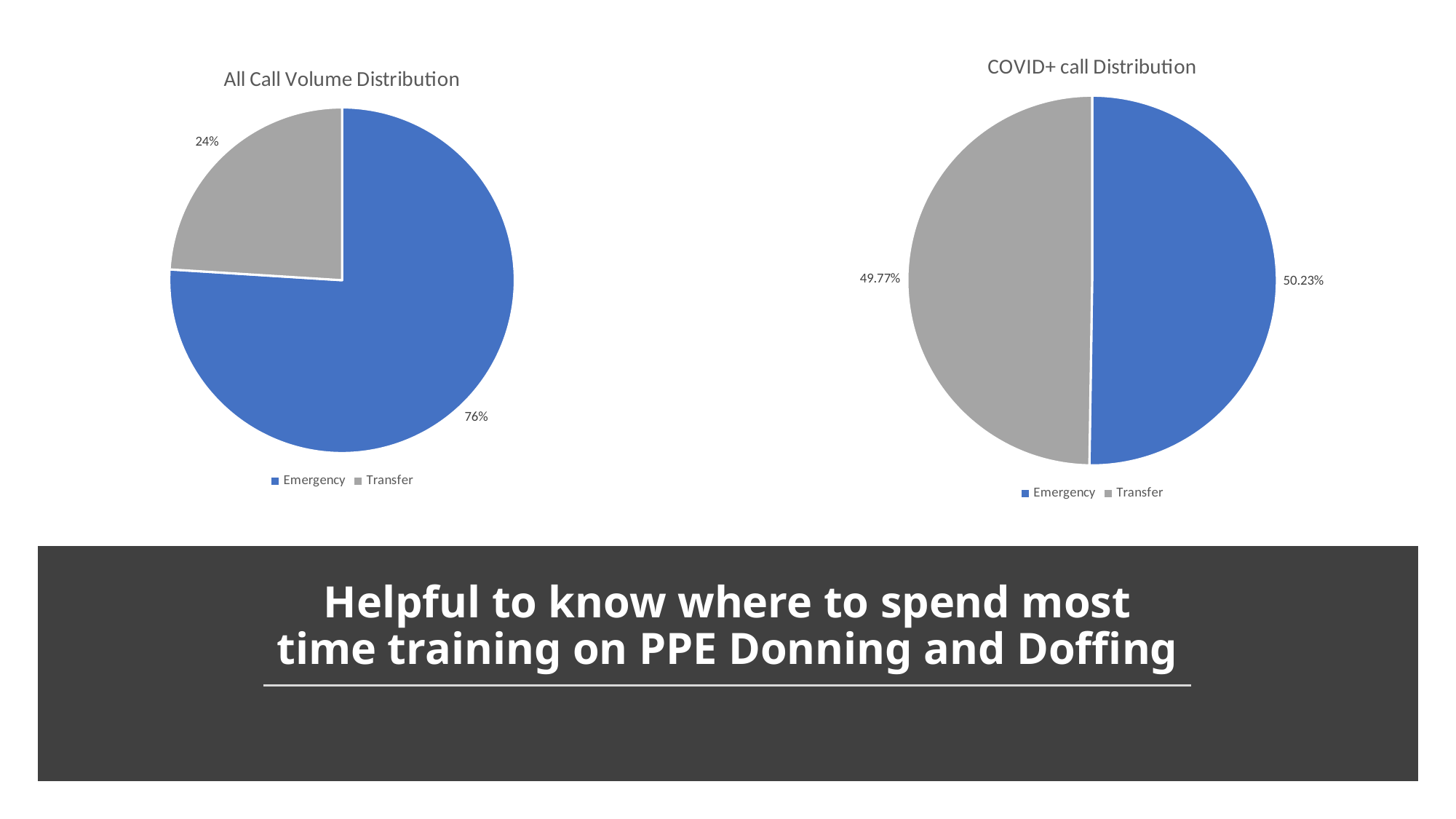
In the 'COVID+ call Distribution' chart, which colour represents Transfer? Grey In the 'All Call Volume Distribution' chart, which category has the largest slice? Emergency What is the title of the chart on the right side of the slide? COVID+ call Distribution In the 'All Call Volume Distribution' chart, what share of calls is Transfer? 24% In the 'COVID+ call Distribution' chart, what share of calls is Emergency? 50.23% How many categories does the 'All Call Volume Distribution' chart show? 2 In the 'All Call Volume Distribution' chart, what share of calls is Emergency? 76% In the 'All Call Volume Distribution' chart, what is the difference in percentage points between Emergency and Transfer? 52 In the 'All Call Volume Distribution' chart, which category has the smallest slice? Transfer What kind of chart is the 'COVID+ call Distribution' chart? Pie chart In the 'COVID+ call Distribution' chart, what is the difference in percentage points between Emergency and Transfer? 0.46